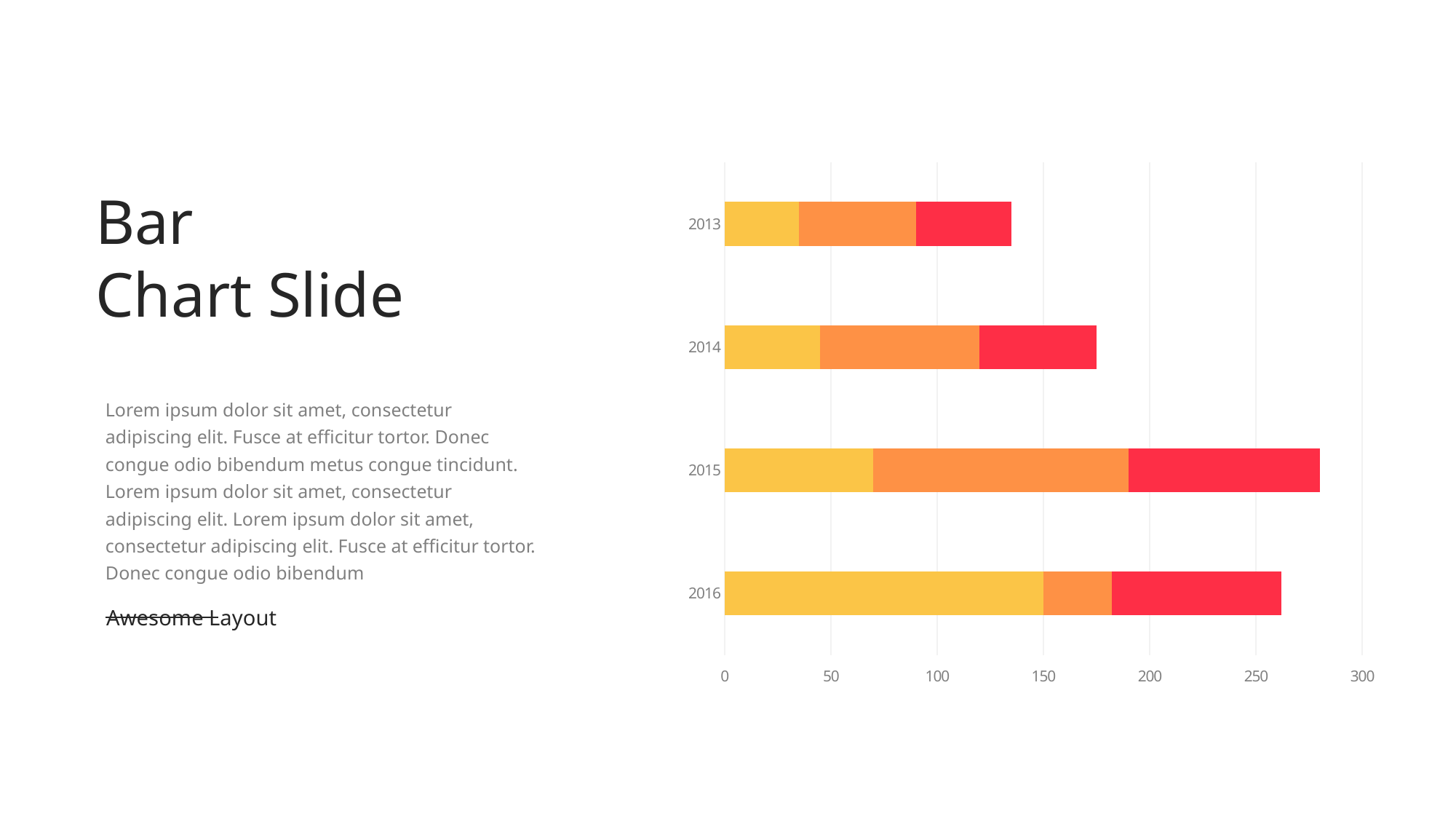
What kind of chart is shown on the slide? bar chart How many coloured segments make up each stacked bar? 3 Is the total bar length for 2013 greater or less than 150? less Which year has the longer total bar, 2015 or 2016? 2015 Which year has the longest total bar? 2015 Is the total bar length for 2014 greater or less than 150? greater Is the total bar length for 2015 greater or less than 250? greater Which year has the shortest total bar? 2013 Which year has the longer total bar, 2013 or 2014? 2014 How many years are shown on the chart's vertical axis? 4 Do the total bar lengths rise or fall from 2013 to 2015? rise